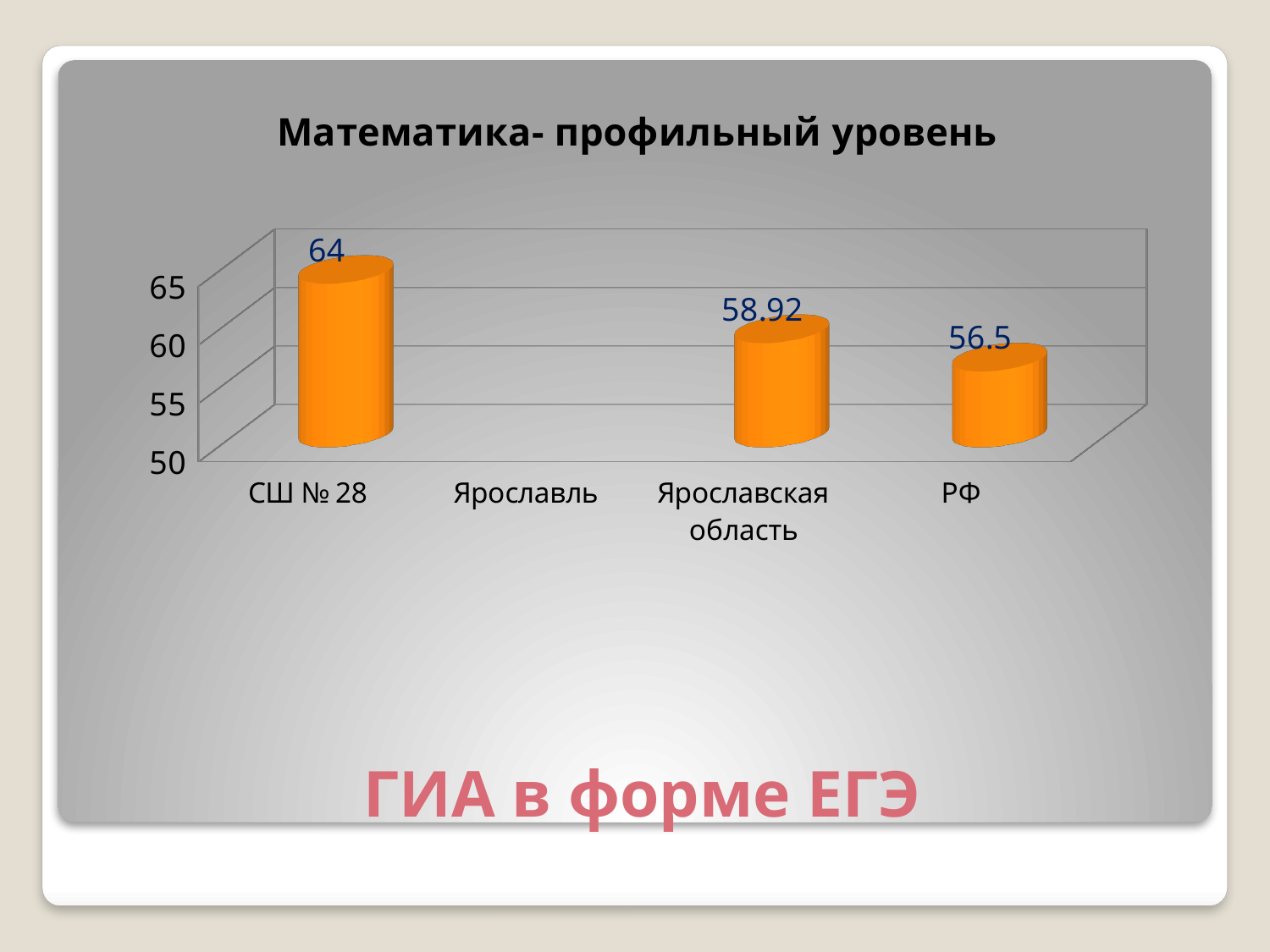
What is the title of the chart? Математика- профильный уровень What is the difference between the values for СШ № 28 and Ярославская область? 5.08 What is the value for СШ № 28? 64 What is the value for Ярославская область? 58.92 What kind of chart is shown on the slide? bar chart What is the value for РФ? 56.5 Which category has the highest value? СШ № 28 How many bars are plotted on the chart? 3 Is the value for РФ greater or less than 60? less Which of the plotted bars has the lowest value? РФ What is the difference between the values for СШ № 28 and РФ? 7.5 Which is larger, the value for Ярославская область or the value for РФ? Ярославская область